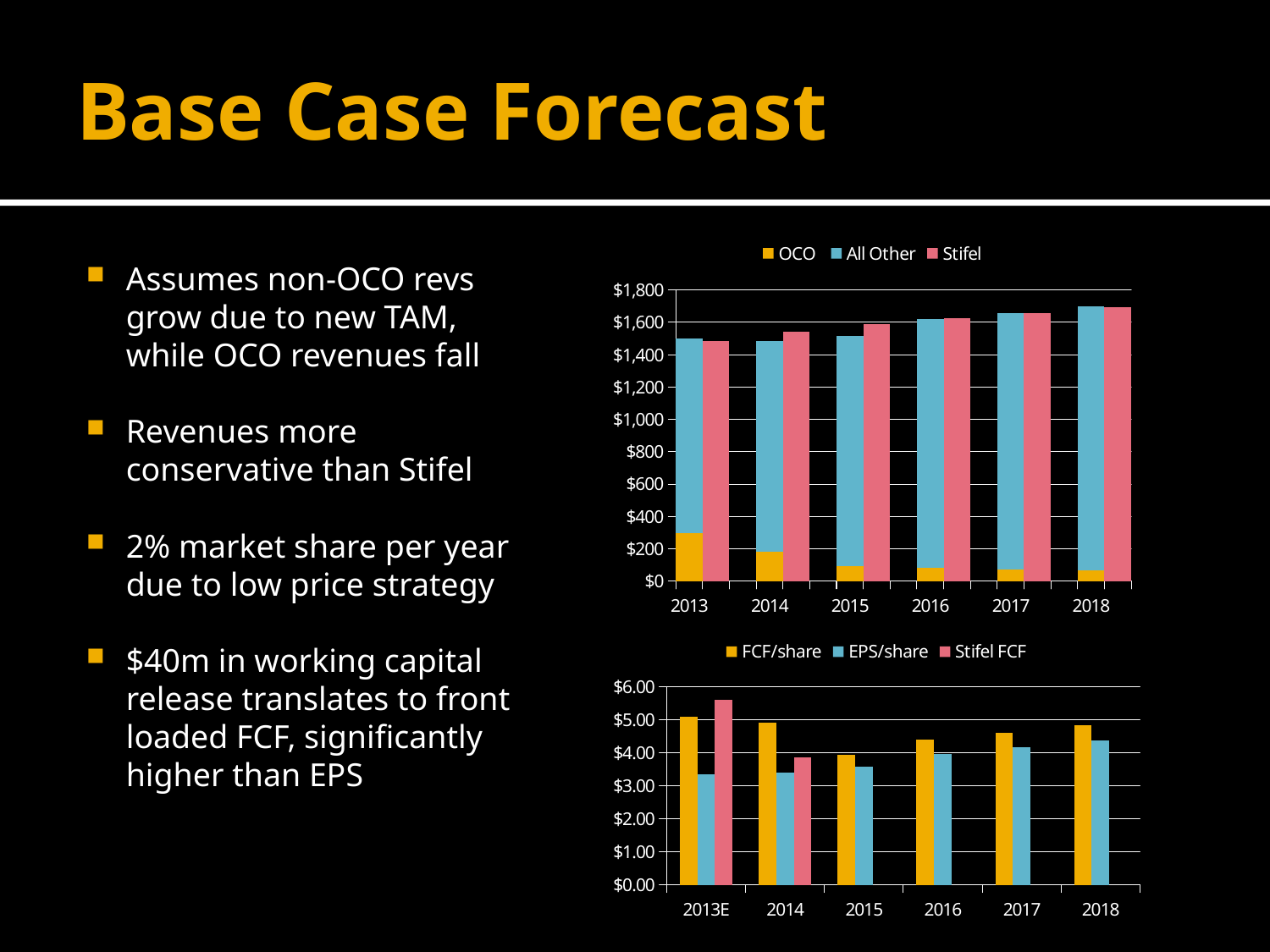
How many series does the legend of the top chart list? 3 In the top chart, which is larger: the OCO value for 2013 or the OCO value for 2018? 2013 What are the three legend entries of the bottom chart? FCF/share, EPS/share, Stifel FCF In the bottom chart, does the EPS/share series rise or fall from 2013E to 2018? rise How many years are shown on the x axis of the top chart? 6 In the bottom chart, is the FCF/share value for 2013E greater or less than $4.00? greater In the top chart, is the Stifel value for 2018 greater or less than $1,600? greater In the top chart, is the OCO value for 2013 greater or less than $200? greater In the top chart, does the OCO series rise or fall from 2013 to 2018? fall In the bottom chart, which year has the highest Stifel FCF value? 2013E What kind of chart is the top chart on the slide? bar chart